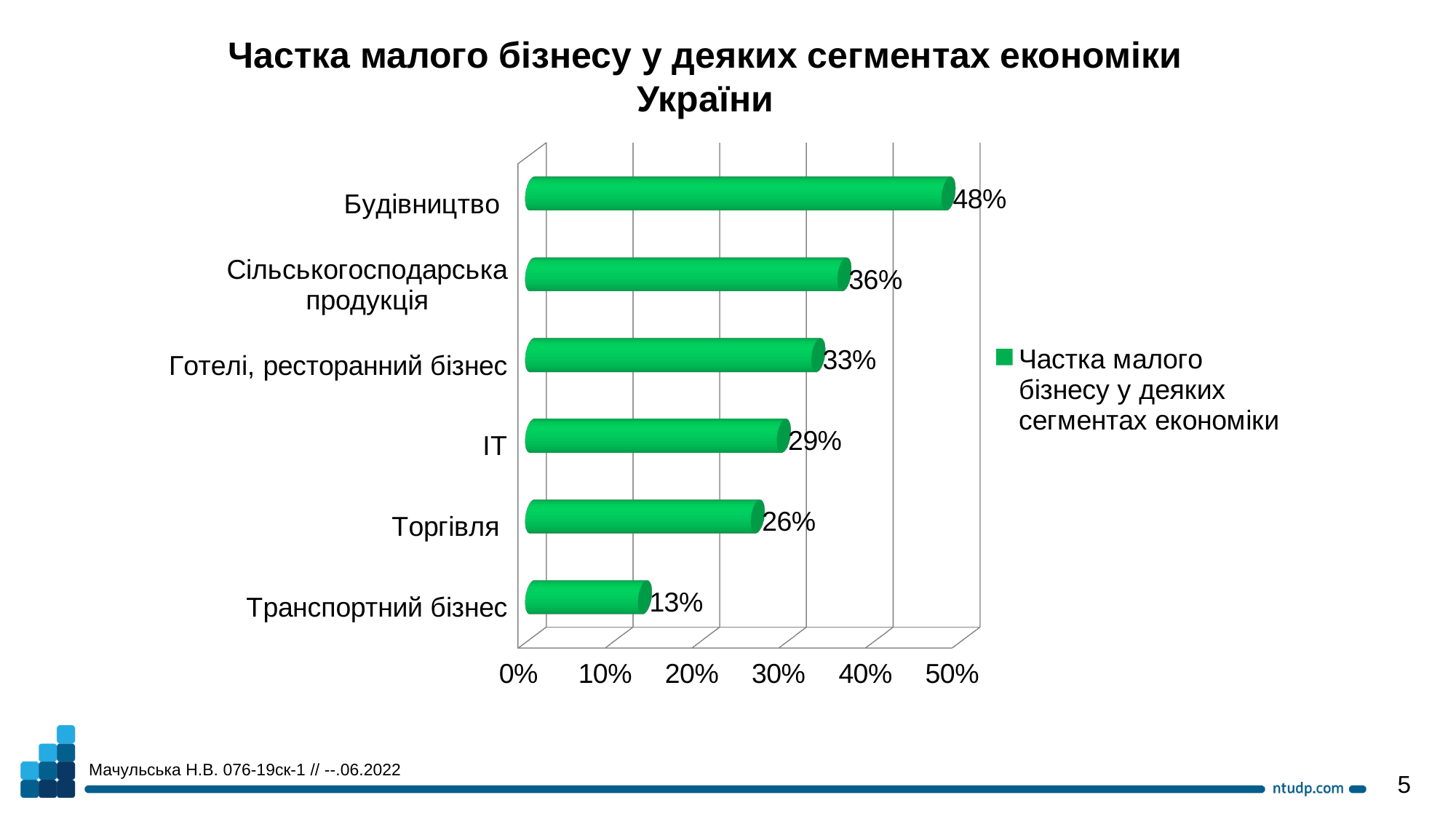
Which category has the highest value? Будівництво What is the value for Будівництво? 48% What is the difference between the values for Будівництво and Торгівля? 22% What is the title of the chart? Частка малого бізнесу у деяких сегментах економіки України What is the value for Сільськогосподарська продукція? 36% How many series does the legend list? 1 Which category has the lowest value? Транспортний бізнес What is the value for Транспортний бізнес? 13% How many categories are shown in the chart? 6 Which is larger, the value for Готелі, ресторанний бізнес or the value for IT? Готелі, ресторанний бізнес What kind of chart is shown on the slide? Bar chart What is the value for IT? 29%